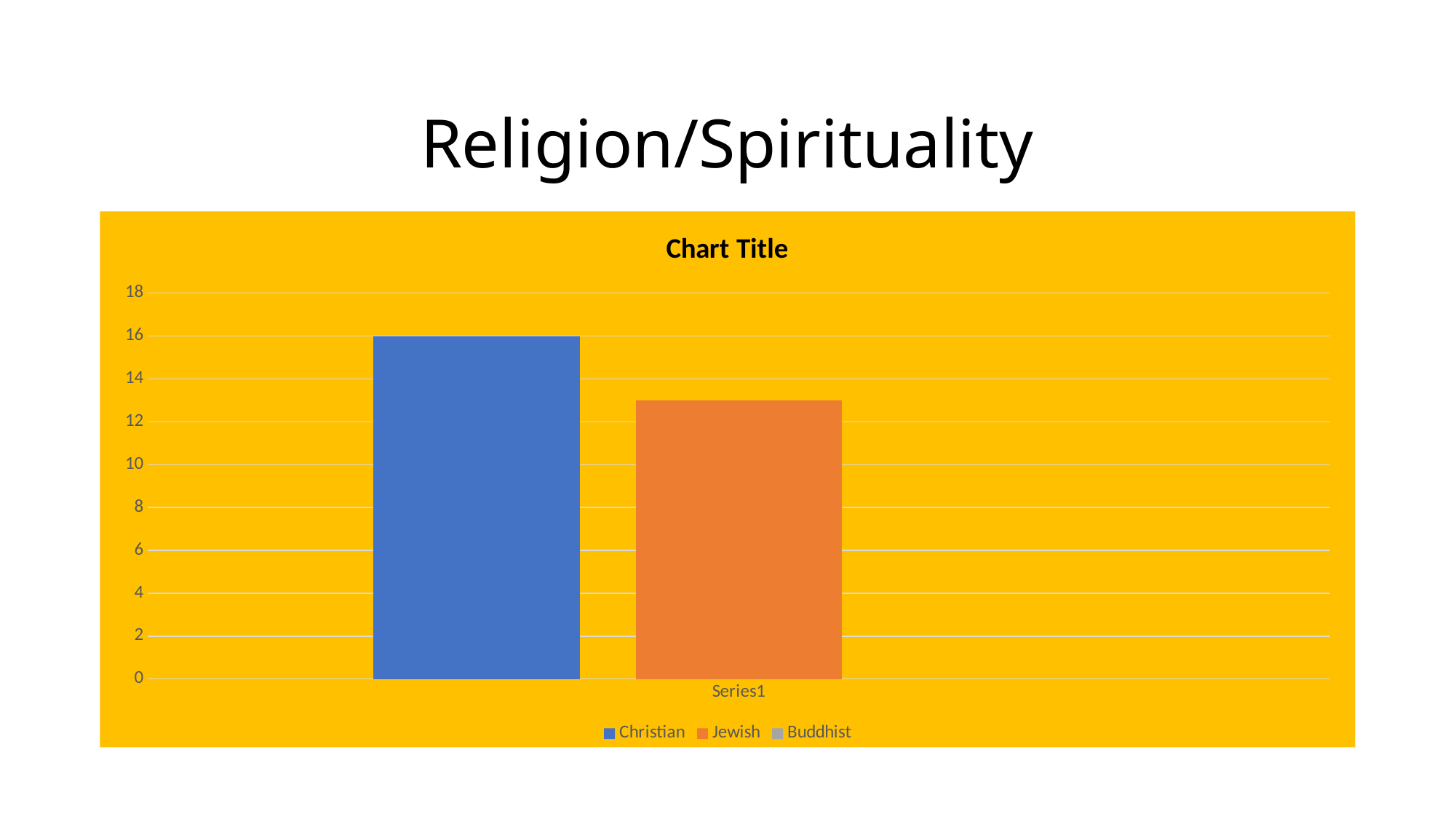
Is the value for Christian greater or less than 10? greater What are the three entries in the legend? Christian, Jewish, Buddhist How many categories are labelled on the x axis? 1 Which series has the highest bar? Christian Which is larger, the Christian bar or the Jewish bar? Christian What kind of chart is shown on the slide? bar chart What is the value of the Christian bar? 16 Is the value for Jewish greater or less than 12? greater Is the value for Jewish greater or less than 14? less What is the title shown above the chart? Chart Title How many series does the legend list? 3